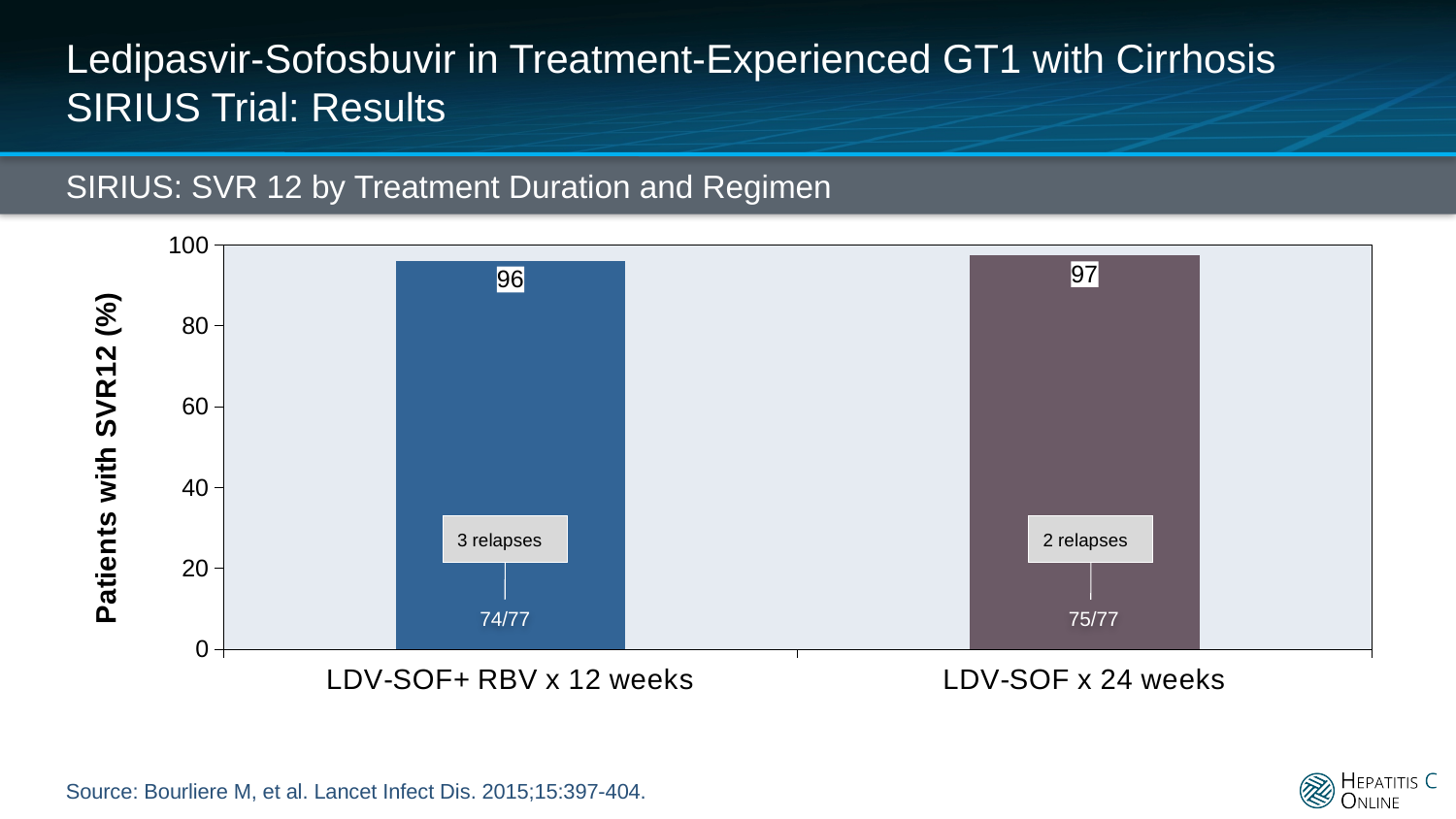
Is the SVR12 rate for LDV-SOF+ RBV x 12 weeks greater or less than 80? greater What kind of chart is shown on the slide? bar chart How many relapses are reported for the LDV-SOF x 24 weeks group? 2 relapses What is the SVR12 rate for LDV-SOF x 24 weeks? 97 What is the SVR12 rate for LDV-SOF+ RBV x 12 weeks? 96 What is the difference in SVR12 rate between LDV-SOF x 24 weeks and LDV-SOF+ RBV x 12 weeks? 1 Which treatment regimen has the higher SVR12 rate? LDV-SOF x 24 weeks Which treatment regimen has the lower SVR12 rate? LDV-SOF+ RBV x 12 weeks How many relapses are reported for the LDV-SOF+ RBV x 12 weeks group? 3 relapses What fraction of patients achieved SVR12 in the LDV-SOF x 24 weeks group? 75/77 What is the label of the y-axis of the chart? Patients with SVR12 (%) How many treatment regimens are shown in the chart? 2